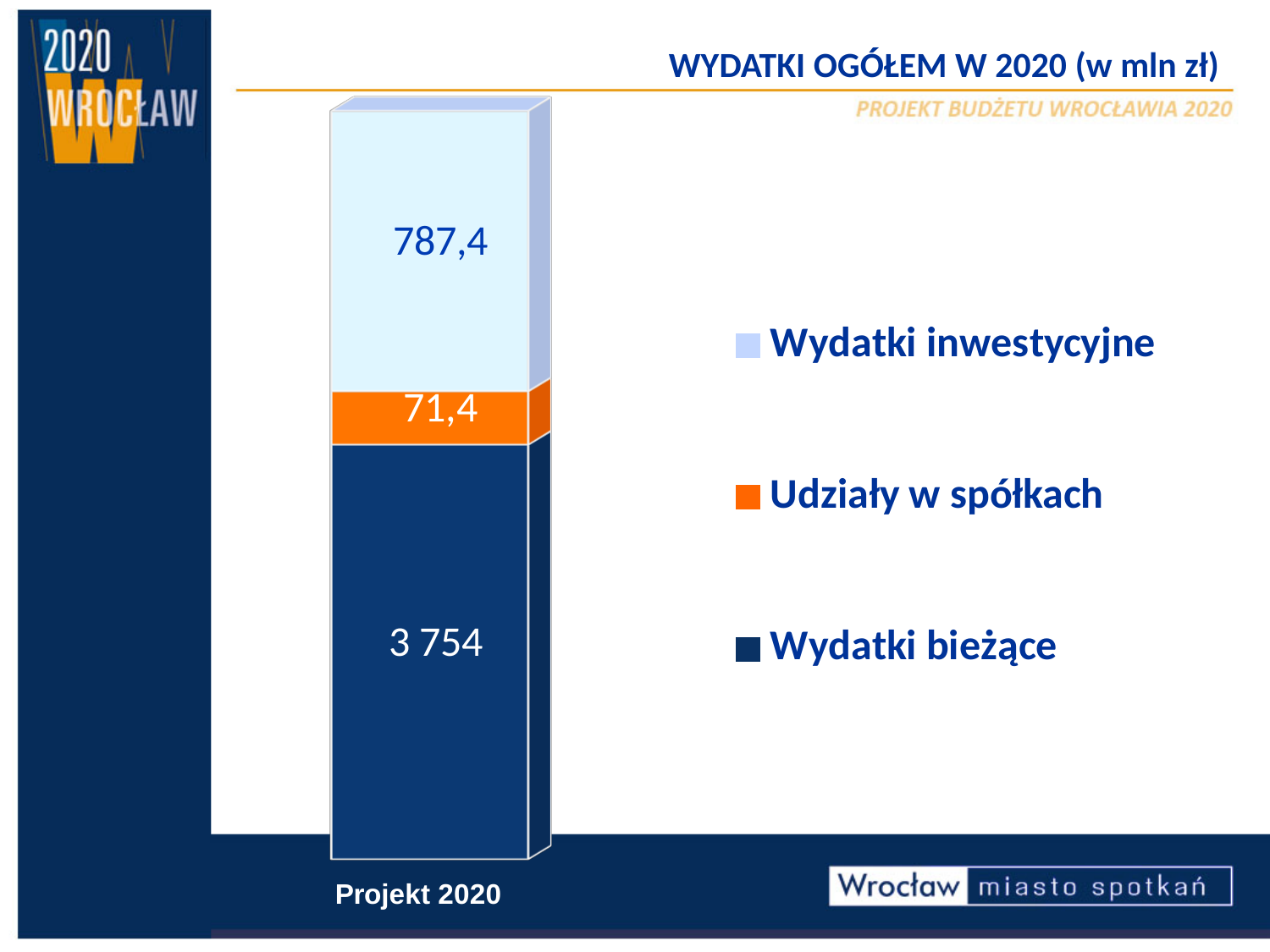
How many series does the legend list? 3 What is the title of the chart? WYDATKI OGÓŁEM W 2020 (w mln zł) What is the difference between Wydatki inwestycyjne and Udziały w spółkach? 716 What is the value for Wydatki bieżące in the Projekt 2020 bar? 3 754 What kind of chart is shown on the slide? Stacked bar chart What is the value for Wydatki inwestycyjne in the Projekt 2020 bar? 787,4 Which series has the largest value in the Projekt 2020 bar? Wydatki bieżące What is the difference between Wydatki bieżące and Wydatki inwestycyjne? 2 966,6 Which series has the smallest value in the Projekt 2020 bar? Udziały w spółkach Which is larger, Wydatki inwestycyjne or Udziały w spółkach? Wydatki inwestycyjne What is the value for Udziały w spółkach in the Projekt 2020 bar? 71,4 What is the total of the Projekt 2020 stacked bar? 4 612,8